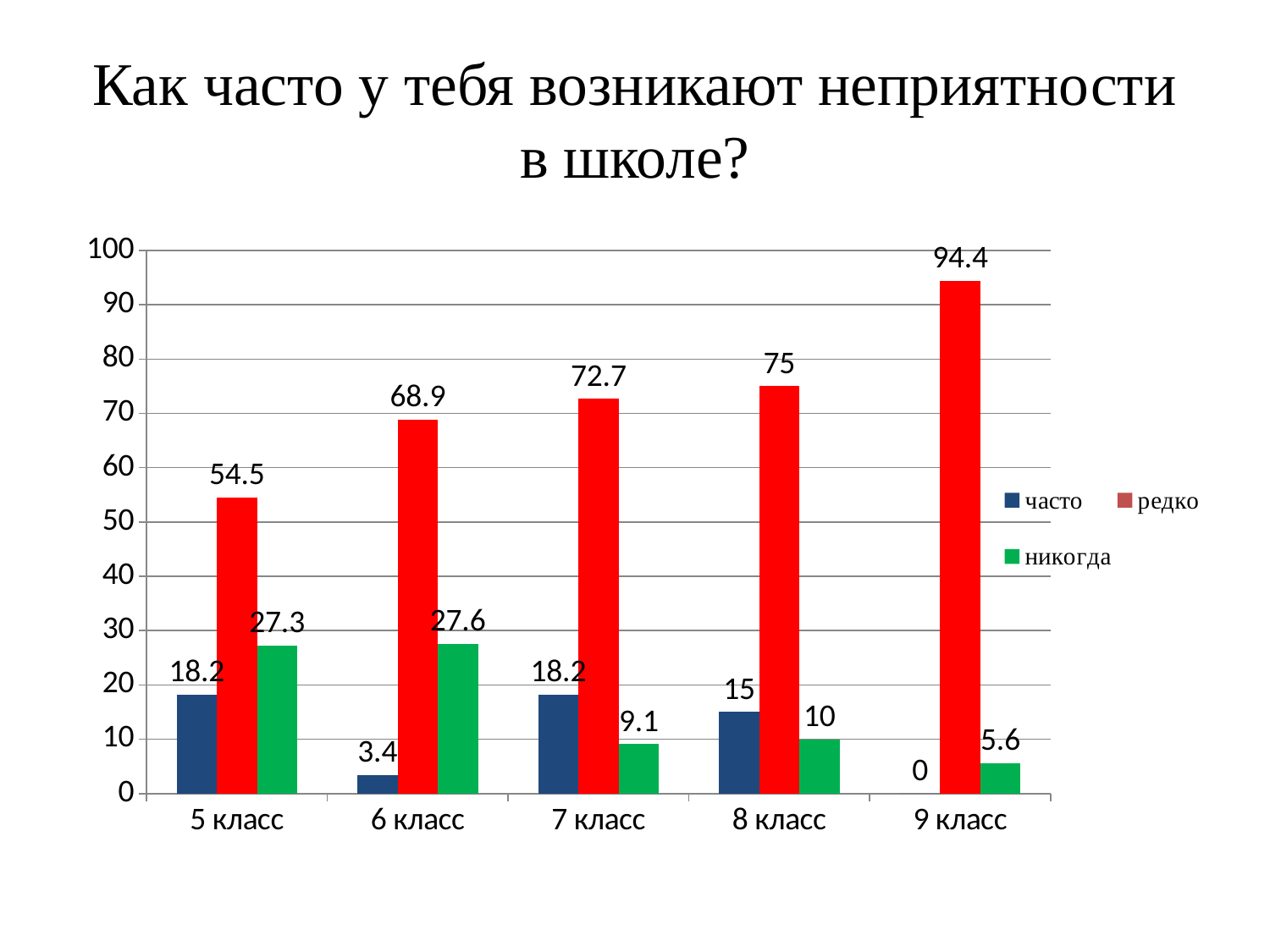
Is the value for "редко" in 8 класс greater or less than 70? greater How many classes are shown on the x axis? 5 What is the value for "никогда" in 7 класс? 9.1 What is the value for "часто" in 6 класс? 3.4 What kind of chart is shown on the slide? bar chart Do the "редко" values rise or fall from 5 класс to 9 класс? rise Which class has the highest value for "редко"? 9 класс Which class has the lowest value for "никогда"? 9 класс How many series does the legend list? 3 What is the difference between the "редко" values for 9 класс and 5 класс? 39.9 What is the value for "редко" in 9 класс? 94.4 Which is larger: the "никогда" value for 5 класс or for 6 класс? 6 класс